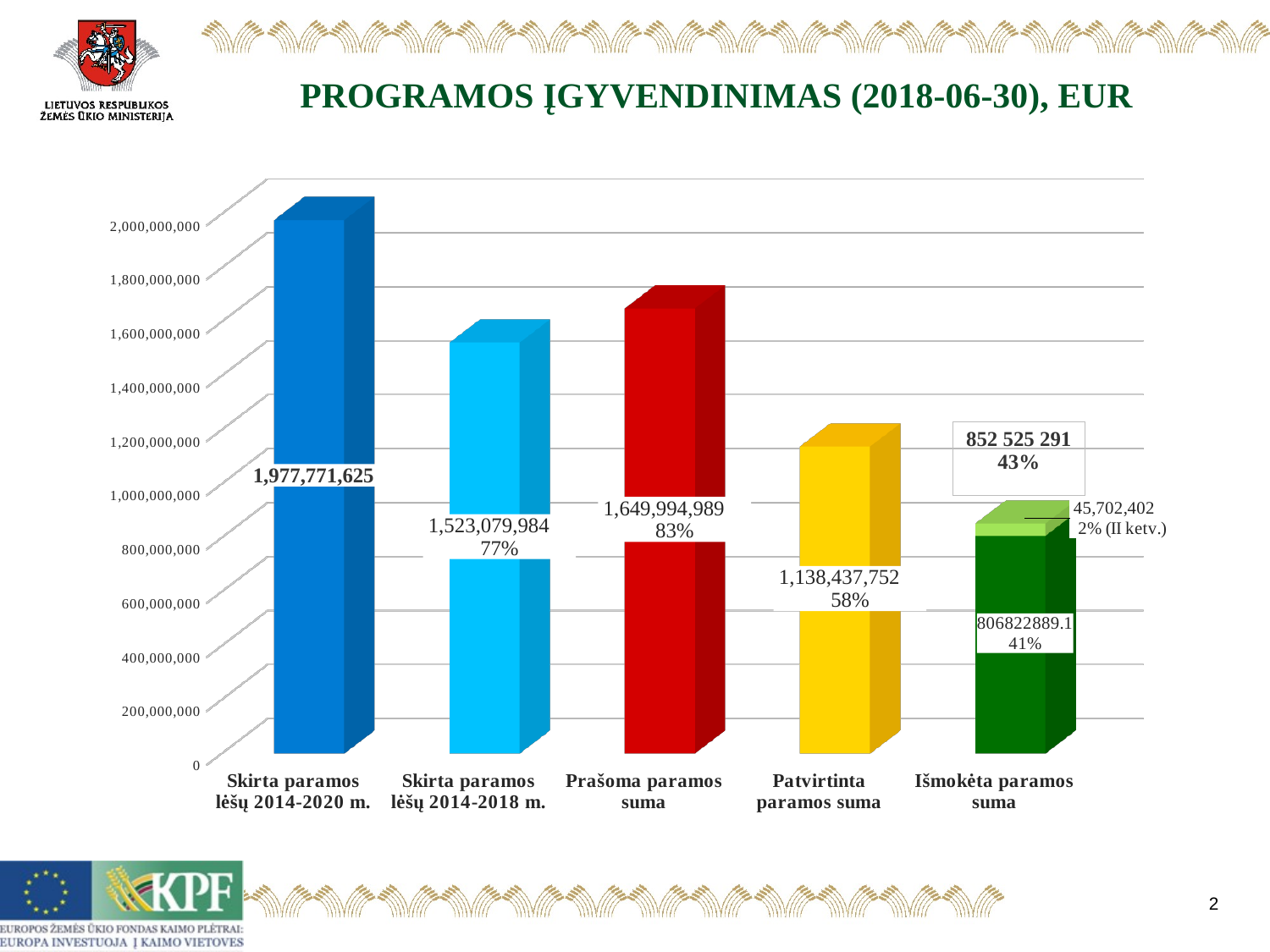
Which category has the highest value? Skirta paramos lėšų 2014-2020 m. What is the value for Patvirtinta paramos suma? 1,138,437,752 What is the difference between Skirta paramos lėšų 2014-2020 m. and Skirta paramos lėšų 2014-2018 m.? 454,691,641 What percentage is shown for Skirta paramos lėšų 2014-2018 m.? 77% What is the value for Skirta paramos lėšų 2014-2020 m.? 1,977,771,625 Which is larger, Prašoma paramos suma or Patvirtinta paramos suma? Prašoma paramos suma What type of chart is shown on the slide? Bar chart Which category has the lowest value? Išmokėta paramos suma What is the total shown for the Išmokėta paramos suma bar? 852 525 291 What is the value of the light green top segment of the Išmokėta paramos suma bar? 45,702,402 How many categories are shown on the x axis? 5 What is the value for Prašoma paramos suma? 1,649,994,989